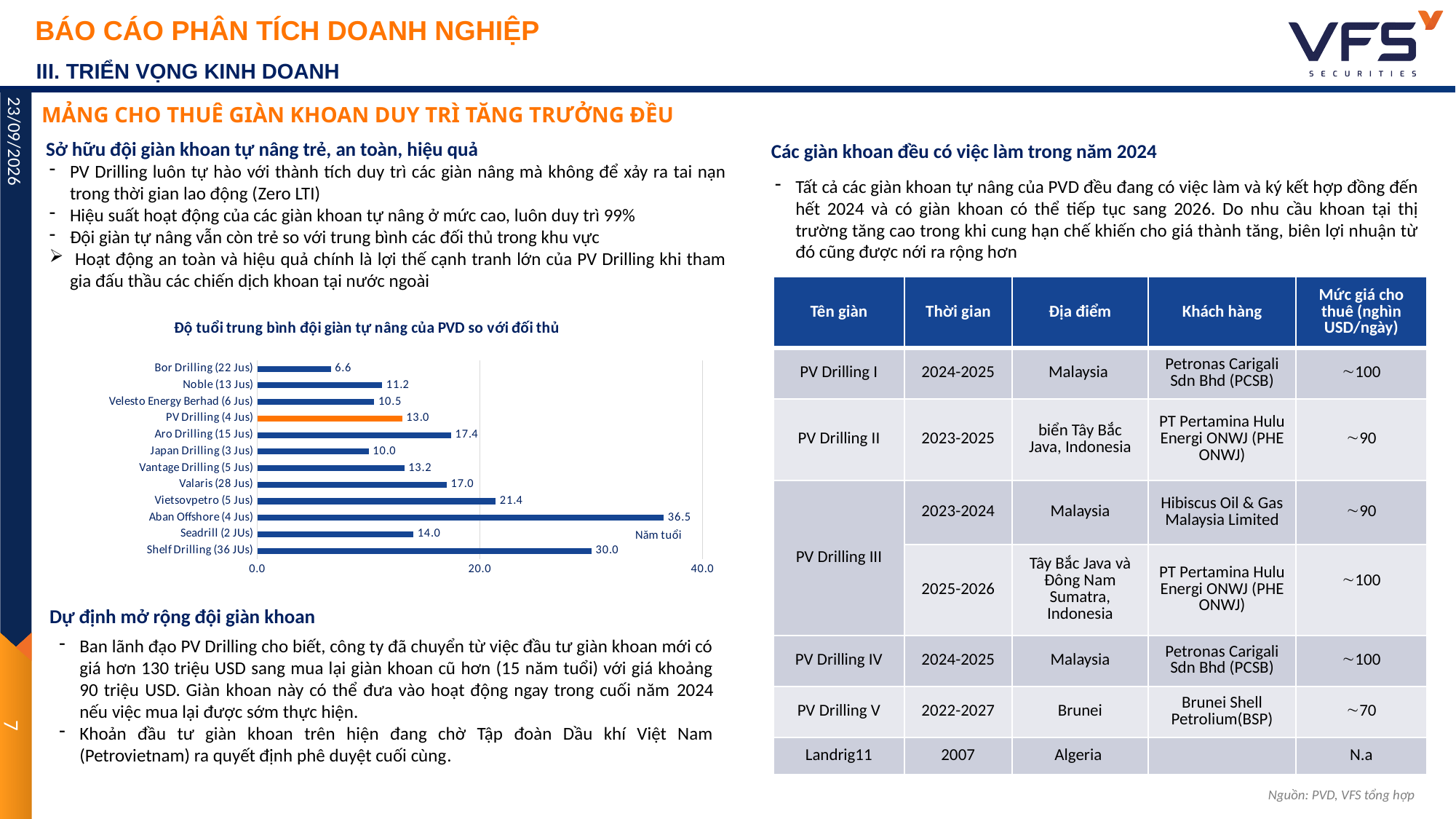
Which company has the highest average rig age in the chart? Aban Offshore (4 Jus) What is the difference between the values for Shelf Drilling (36 JUs) and PV Drilling (4 Jus)? 17.0 Which has a higher value, Valaris (28 Jus) or Noble (13 Jus)? Valaris (28 Jus) What is the title of the chart? Độ tuổi trung bình đội giàn tự nâng của PVD so với đối thủ What is the value shown for Vietsovpetro (5 Jus)? 21.4 Which company has the lowest average rig age in the chart? Bor Drilling (22 Jus) Is the value for Shelf Drilling (36 JUs) greater or less than 20.0? greater What is the average rig age shown for PV Drilling (4 Jus)? 13.0 What type of chart is shown on the slide? bar chart What is the value shown for Aban Offshore (4 Jus)? 36.5 Which bar in the chart is coloured orange instead of blue? PV Drilling (4 Jus) How many companies are listed in the chart? 12